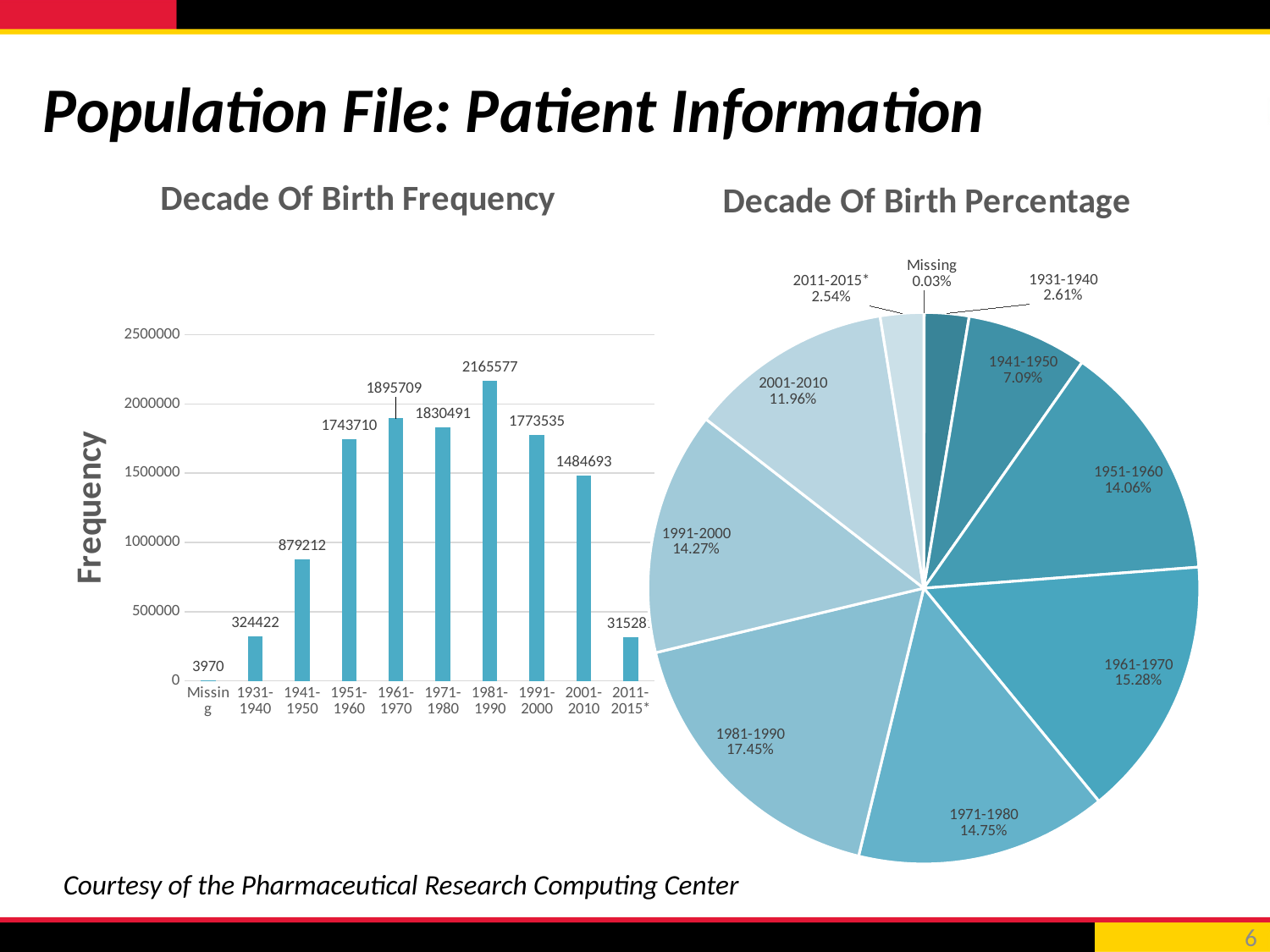
In the Decade Of Birth Frequency chart, what is the frequency for 1941-1950? 879212 What kind of chart is the Decade Of Birth Percentage chart? Pie chart In the Decade Of Birth Percentage chart, what share does 1961-1970 have? 15.28% In the Decade Of Birth Frequency chart, which category has the lowest frequency? Missing How many categories are shown in the Decade Of Birth Frequency chart? 10 In the Decade Of Birth Frequency chart, what is the frequency for 1981-1990? 2165577 In the Decade Of Birth Frequency chart, is the value for 2001-2010 greater or less than 1500000? less In the Decade Of Birth Frequency chart, which is larger, the frequency for 1971-1980 or for 1991-2000? 1971-1980 What kind of chart is the Decade Of Birth Frequency chart? Bar chart In the Decade Of Birth Frequency chart, what is the difference between the frequencies for 1961-1970 and 1951-1960? 151999 In the Decade Of Birth Frequency chart, which category has the highest frequency? 1981-1990 In the Decade Of Birth Percentage chart, which slice is the largest? 1981-1990